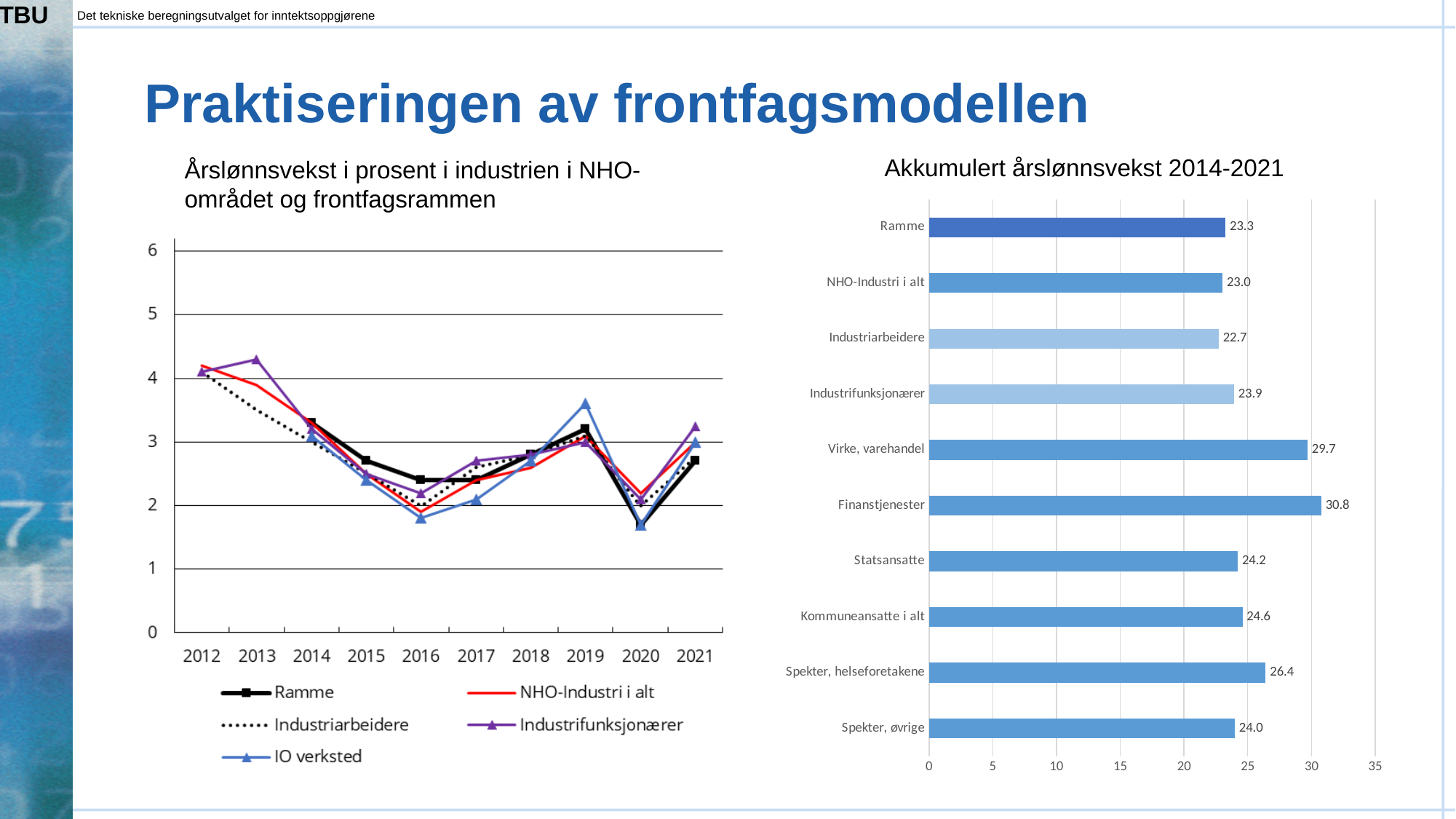
In the chart titled 'Akkumulert årslønnsvekst 2014-2021', what is the difference between Virke, varehandel and Ramme? 6.4 In the left chart (Årslønnsvekst i prosent i industrien i NHO-området og frontfagsrammen), does the Ramme series rise or fall from 2014 to 2016? fall In the chart titled 'Akkumulert årslønnsvekst 2014-2021', what is the value for Finanstjenester? 30.8 How many years are shown on the x axis of the left chart (Årslønnsvekst i prosent i industrien i NHO-området og frontfagsrammen)? 10 In the chart titled 'Akkumulert årslønnsvekst 2014-2021', which category has the lowest value? Industriarbeidere In the left chart (Årslønnsvekst i prosent i industrien i NHO-området og frontfagsrammen), is the value for Ramme in 2020 greater or less than 2? less In the chart titled 'Akkumulert årslønnsvekst 2014-2021', what is the value for Ramme? 23.3 What kind of chart is the chart titled 'Akkumulert årslønnsvekst 2014-2021'? Bar chart In the chart titled 'Akkumulert årslønnsvekst 2014-2021', which category has the highest value? Finanstjenester How many series does the legend of the left chart (Årslønnsvekst i prosent i industrien i NHO-området og frontfagsrammen) list? 5 In the chart titled 'Akkumulert årslønnsvekst 2014-2021', which is larger: Statsansatte or Kommuneansatte i alt? Kommuneansatte i alt How many categories are shown in the chart titled 'Akkumulert årslønnsvekst 2014-2021'? 10